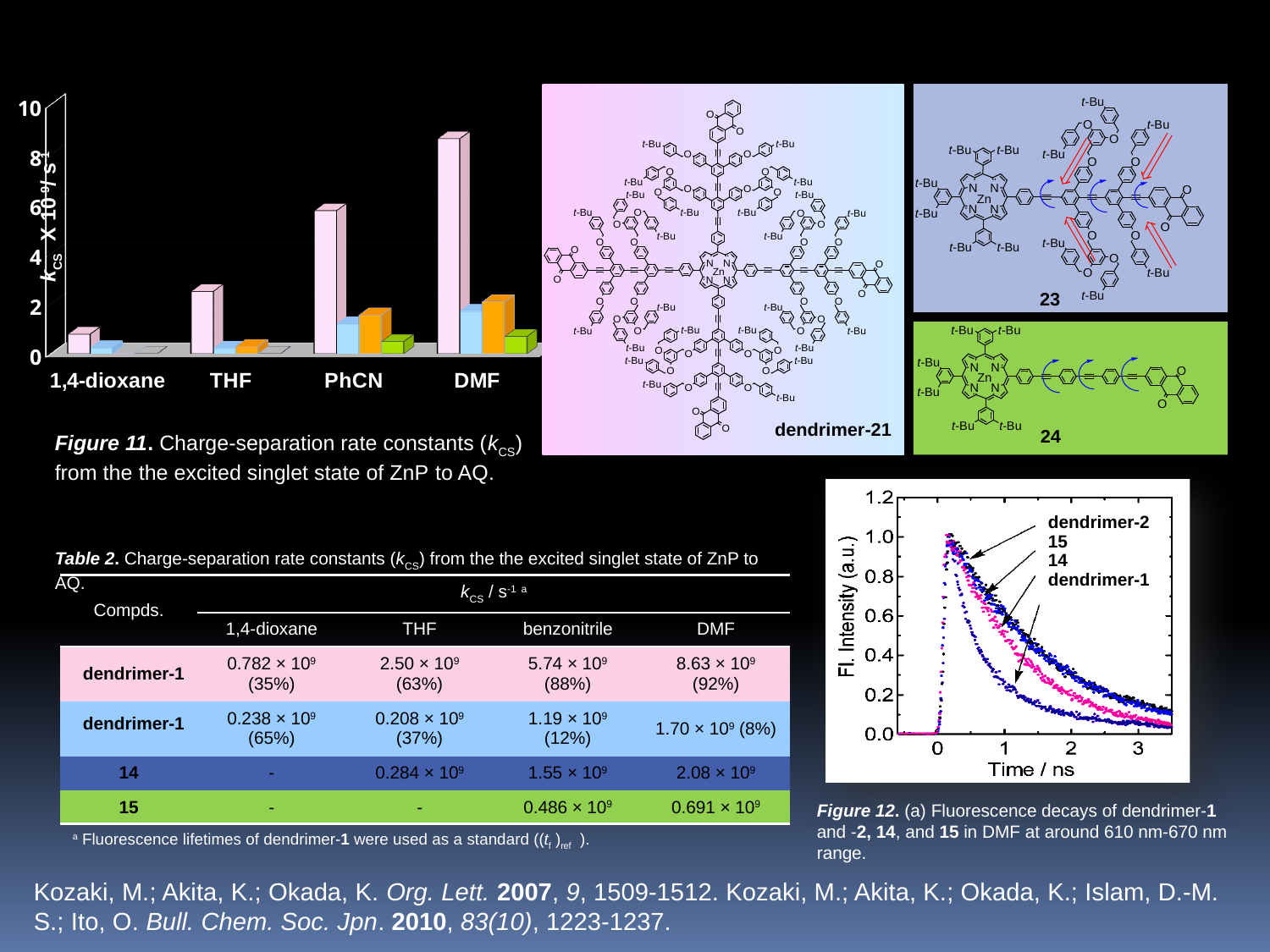
In the bar chart of Figure 11, is the tallest bar for PhCN greater or less than 4? greater In the bar chart of Figure 11, is the tallest bar for DMF greater or less than 8? greater In the bar chart of Figure 11, is the tallest bar for 1,4-dioxane greater or less than 2? less In the bar chart of Figure 11, which solvent has the tallest bar? DMF In Figure 12, how many decay curves are labelled in the plot? 4 In the bar chart of Figure 11, which solvent has the shortest tallest bar? 1,4-dioxane In the bar chart of Figure 11, what kind of chart is used to show the charge-separation rate constants? bar chart In Figure 12, what is the label of the x axis? Time / ns In the bar chart of Figure 11, how many solvent categories are shown on the x axis? 4 In the bar chart of Figure 11, do the tallest bars rise or fall going from 1,4-dioxane to DMF along the x axis? rise In the bar chart of Figure 11, what is the highest value shown on the y axis? 10 In the bar chart of Figure 11, which has the taller tallest bar, THF or PhCN? PhCN